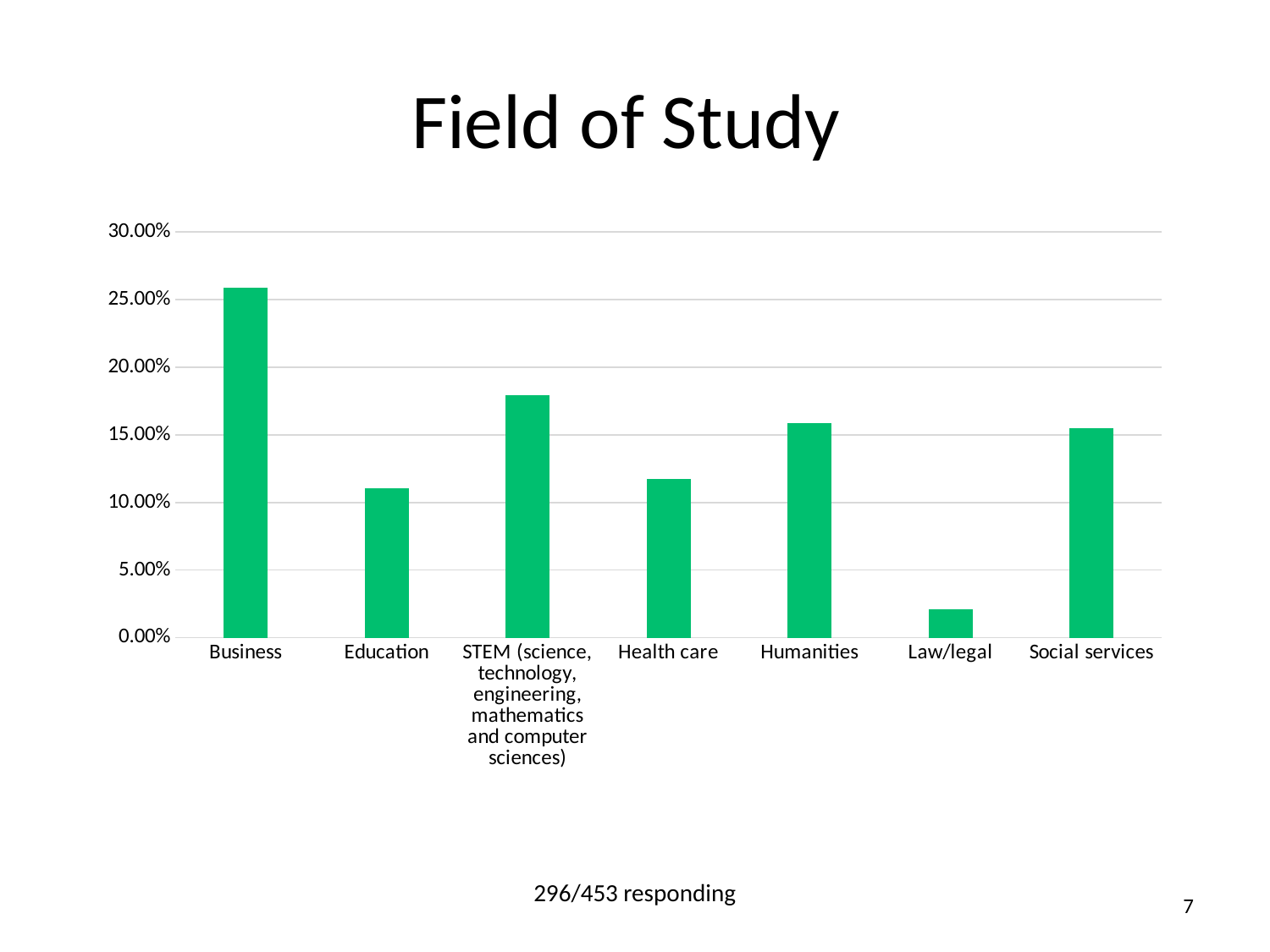
Is the value for STEM (science, technology, engineering, mathematics and computer sciences) greater or less than 20.00%? less What colour are the bars in the chart? green What is the title of the chart? Field of Study Is the value for Business greater or less than 25.00%? greater How many fields of study are shown on the x axis? 7 Is the value for Education greater or less than 10.00%? greater Which field of study has the highest value? Business Which field of study has the lowest value? Law/legal Which has a larger value, Business or Education? Business What type of chart is shown on the slide? bar chart Which has a larger value, STEM (science, technology, engineering, mathematics and computer sciences) or Health care? STEM (science, technology, engineering, mathematics and computer sciences)